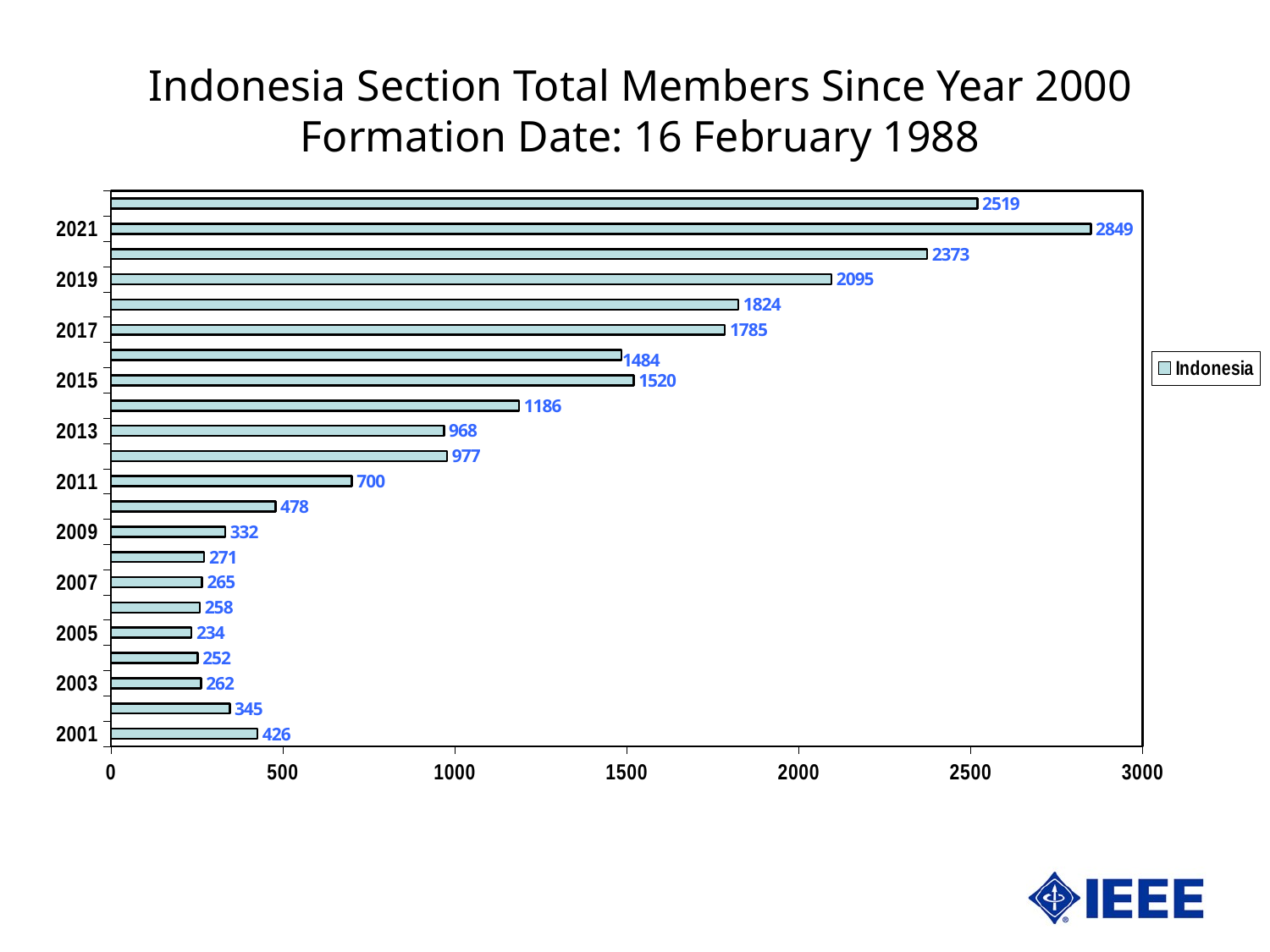
What is the value for 2015? 1520 What is the value for 2021? 2849 Which year has the lowest value? 2005 Which year has the highest value? 2021 What kind of chart is shown? bar chart How many bars are plotted in the chart? 22 How many series does the legend list? 1 What is the difference between the values for 2021 and 2019? 754 What is the value for 2011? 700 Which is larger, the value for 2013 or the value for 2009? 2013 What is the value for 2001? 426 Is the value for 2017 greater or less than 1500? greater